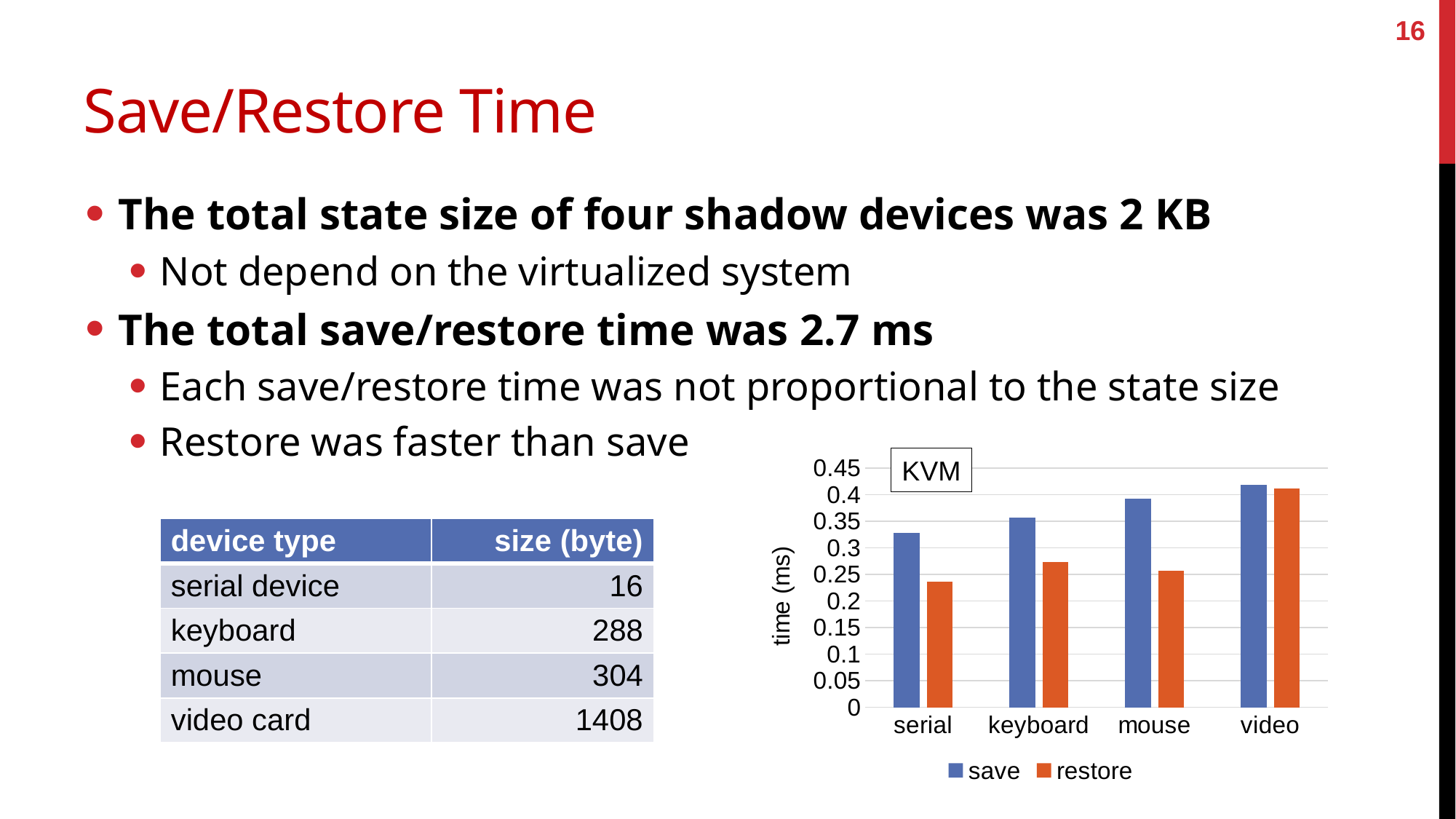
Which device has the lowest restore time in the chart? serial What is the label on the y axis of the chart? time (ms) Which device has the lowest save time in the chart? serial For the mouse, which is larger: the save time or the restore time? save How many device categories are shown on the x axis of the chart? 4 What kind of chart is shown on the slide? bar chart Is the save time for mouse greater or less than 0.35 ms? greater Which device has the highest save time in the chart? video Do the save times rise or fall from serial to video along the x axis? rise Is the restore time for keyboard greater or less than 0.3 ms? less How many series does the chart legend list? 2 Is the save time for serial greater or less than 0.3 ms? greater